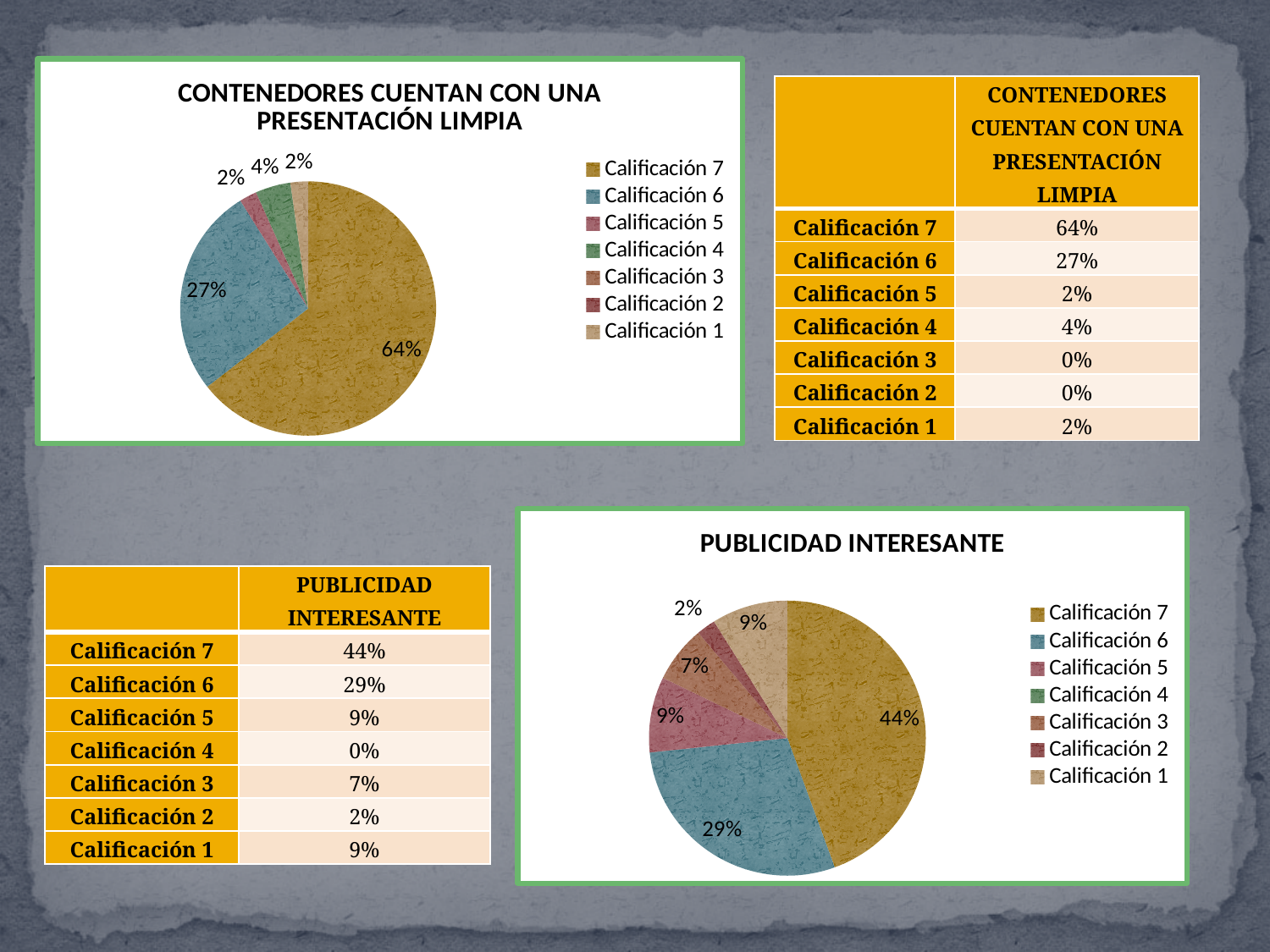
What kind of chart is the one titled PUBLICIDAD INTERESANTE? Pie chart In the pie chart titled CONTENEDORES CUENTAN CON UNA PRESENTACIÓN LIMPIA, which category has the largest slice? Calificación 7 How many pie charts are shown on the slide? 2 In the pie chart titled PUBLICIDAD INTERESANTE, what share does Calificación 7 have? 44% In the pie chart titled CONTENEDORES CUENTAN CON UNA PRESENTACIÓN LIMPIA, what share does Calificación 7 have? 64% In the pie chart titled CONTENEDORES CUENTAN CON UNA PRESENTACIÓN LIMPIA, what is the difference between Calificación 7 and Calificación 6? 37% In the pie chart titled CONTENEDORES CUENTAN CON UNA PRESENTACIÓN LIMPIA, how many entries does the legend list? 7 In the pie chart titled PUBLICIDAD INTERESANTE, what is the difference between Calificación 7 and Calificación 6? 15% In the pie chart titled PUBLICIDAD INTERESANTE, which is larger, Calificación 6 or Calificación 5? Calificación 6 In the pie chart titled PUBLICIDAD INTERESANTE, what is the value for Calificación 6? 29% In the pie chart titled CONTENEDORES CUENTAN CON UNA PRESENTACIÓN LIMPIA, what is the value for Calificación 6? 27% In the pie chart titled PUBLICIDAD INTERESANTE, what is the value for Calificación 3? 7%